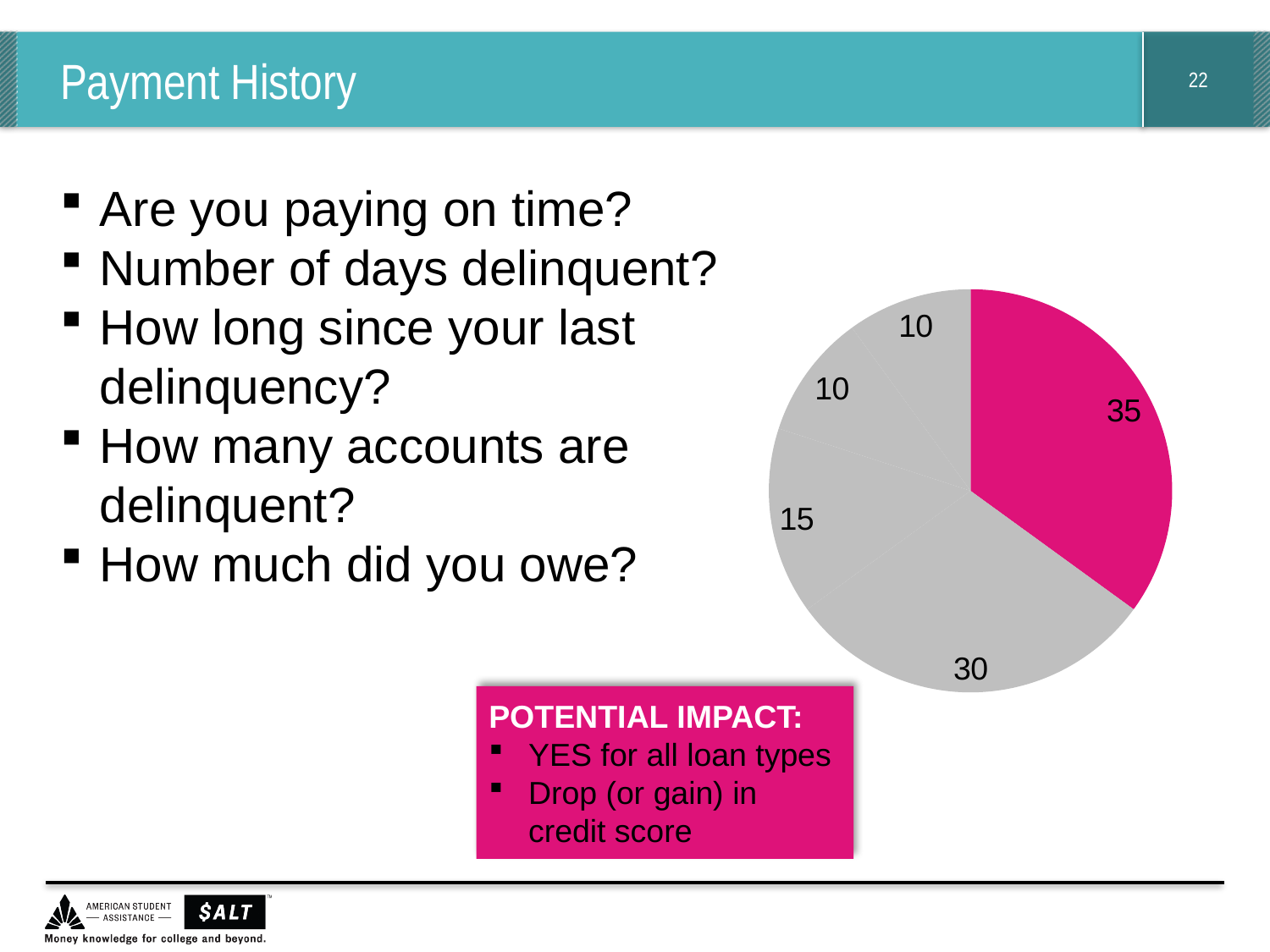
What is the value of the smallest slice in the pie chart? 10 What kind of chart is shown on the slide? Pie chart How many slices in the pie chart are labelled 10? 2 What share of the pie does the slice labelled 30 represent? 30% How many slices does the pie chart have? 5 What is the value of the largest slice in the pie chart? 35 What is the total of all the slice values in the pie chart? 100 What share of the pie does the magenta slice labelled 35 represent? 35% Which is larger: the magenta slice or the gray slice labelled 30? The magenta slice What is the value of the magenta (pink) slice of the pie chart? 35 What is the difference between the slice labelled 35 and the slice labelled 30? 5 What colour is the largest slice of the pie chart? Magenta (pink)